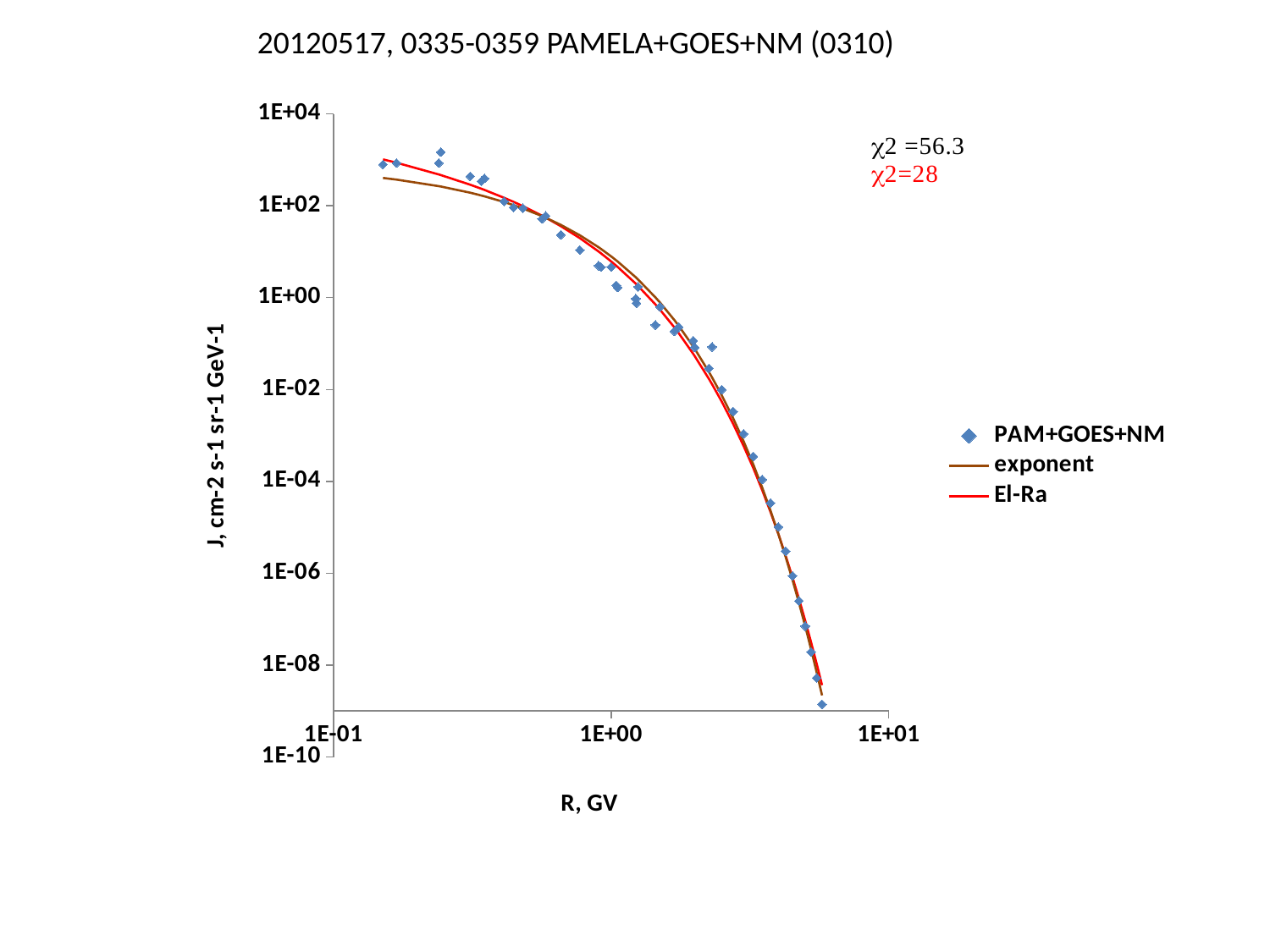
Which series in the legend is drawn as a red line? El-Ra What is the highest tick value shown on the y axis? 1E+04 Is the J value of the PAM+GOES+NM points at the lowest R (around 1.5E-01 GV) greater or less than 1E+02? greater What χ2 value is given in black text on the chart? 56.3 What is the title of the chart? 20120517, 0335-0359 PAMELA+GOES+NM (0310) What kind of chart is shown on the slide? scatter chart Is the J value of the PAM+GOES+NM point at the highest R (around 6 GV) greater or less than 1E-08? less What χ2 value is given for the fit shown in red (El-Ra)? 28 Do the plotted J values rise or fall as R increases along the x axis? fall What is the label of the x axis? R, GV How many series does the legend list? 3 Which χ2 value printed on the chart is smaller, 56.3 or 28? 28